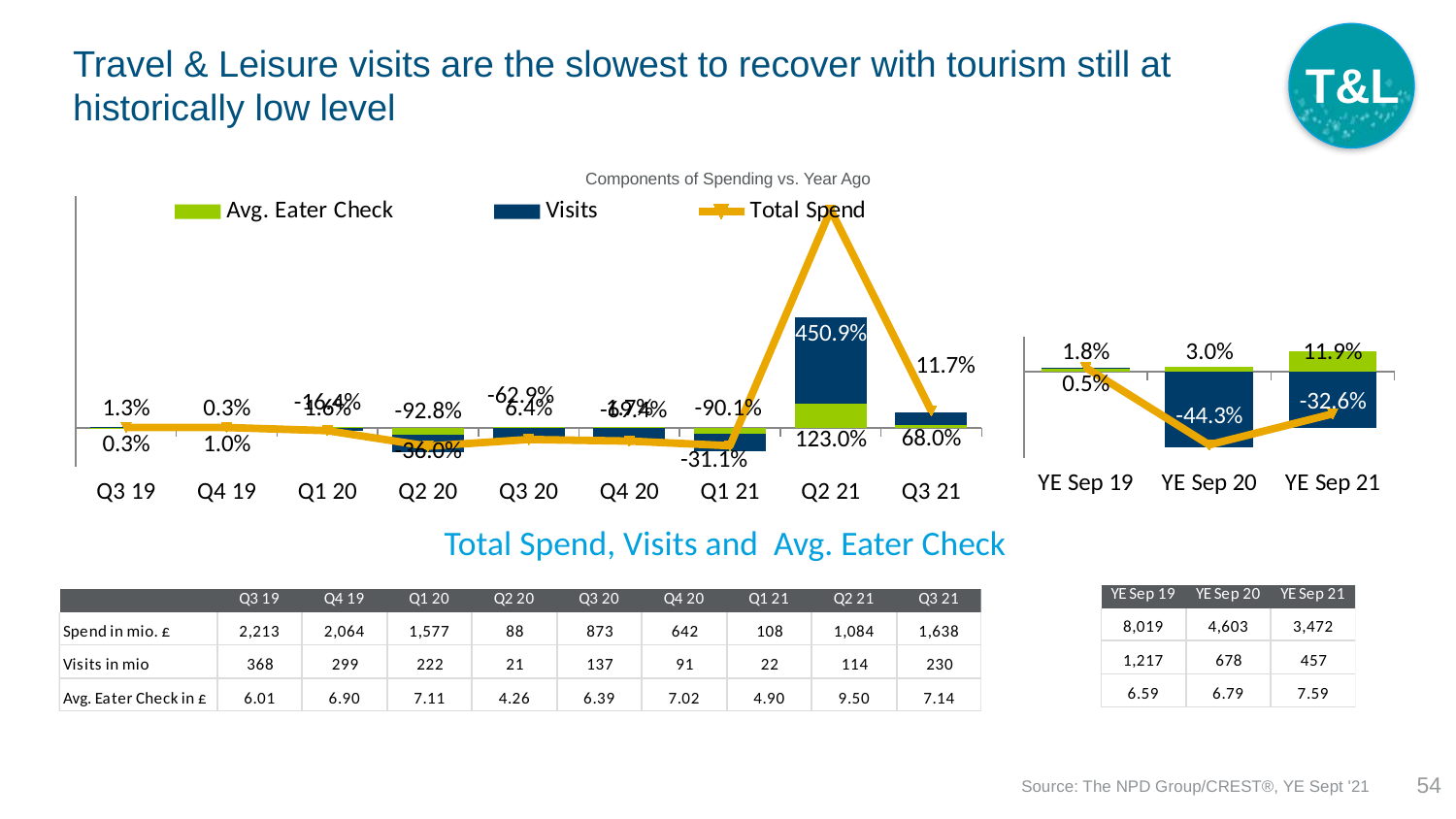
In the right-hand chart (YE Sep 19 to YE Sep 21), what is the value for Visits in YE Sep 20? -44.3% In the right-hand chart, by how many percentage points does Avg. Eater Check in YE Sep 21 exceed Avg. Eater Check in YE Sep 20? 8.9 percentage points In the right-hand chart, what is the value for Avg. Eater Check in YE Sep 19? 1.8% In the right-hand chart, what is the value for Visits in YE Sep 21? -32.6% In the 'Components of Spending vs. Year Ago' chart, what is the value for Visits in Q3 21? 68.0% In the right-hand chart, what is the value for Avg. Eater Check in YE Sep 21? 11.9% In the right-hand chart, which year has the lowest value for Visits? YE Sep 20 In the 'Components of Spending vs. Year Ago' chart, what is the value for Avg. Eater Check in Q2 21? 123.0% In the 'Components of Spending vs. Year Ago' chart, what is the value for Visits in Q2 21? 450.9% How many series does the legend of the 'Components of Spending vs. Year Ago' chart list? 3 How many quarters are shown on the x axis of the 'Components of Spending vs. Year Ago' chart? 9 In the 'Components of Spending vs. Year Ago' chart, which quarter has the highest value for Visits? Q2 21